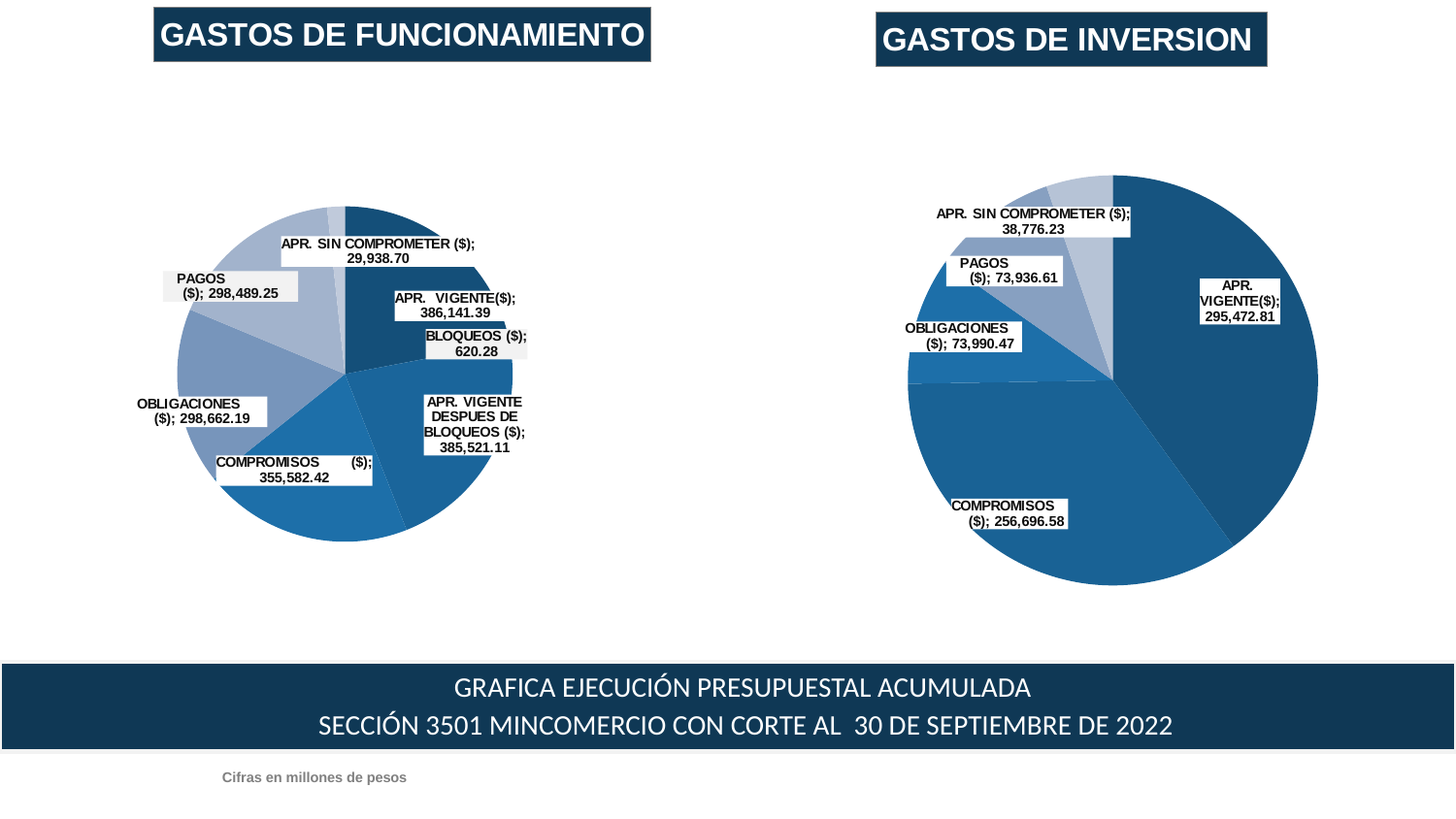
What kind of chart is the GASTOS DE INVERSION chart? Pie chart In the GASTOS DE FUNCIONAMIENTO chart, which is larger, COMPROMISOS ($) or OBLIGACIONES ($)? COMPROMISOS ($) In the GASTOS DE INVERSION chart, which category has the largest value? APR. VIGENTE ($) In the GASTOS DE FUNCIONAMIENTO chart, what is the difference between APR. VIGENTE ($) and APR. VIGENTE DESPUES DE BLOQUEOS ($)? 620.28 How many categories are labelled in the GASTOS DE FUNCIONAMIENTO chart? 7 In the GASTOS DE FUNCIONAMIENTO chart, which category has the smallest value? BLOQUEOS ($) In the GASTOS DE INVERSION chart, what is the value for PAGOS ($)? 73,936.61 In the GASTOS DE FUNCIONAMIENTO chart, what is the value for BLOQUEOS ($)? 620.28 In the GASTOS DE INVERSION chart, what is the value for COMPROMISOS ($)? 256,696.58 In the GASTOS DE FUNCIONAMIENTO chart, what is the value for APR. VIGENTE ($)? 386,141.39 In the GASTOS DE INVERSION chart, what is the difference between APR. VIGENTE ($) and COMPROMISOS ($)? 38,776.23 In the GASTOS DE INVERSION chart, which category has the smallest value? APR. SIN COMPROMETER ($)